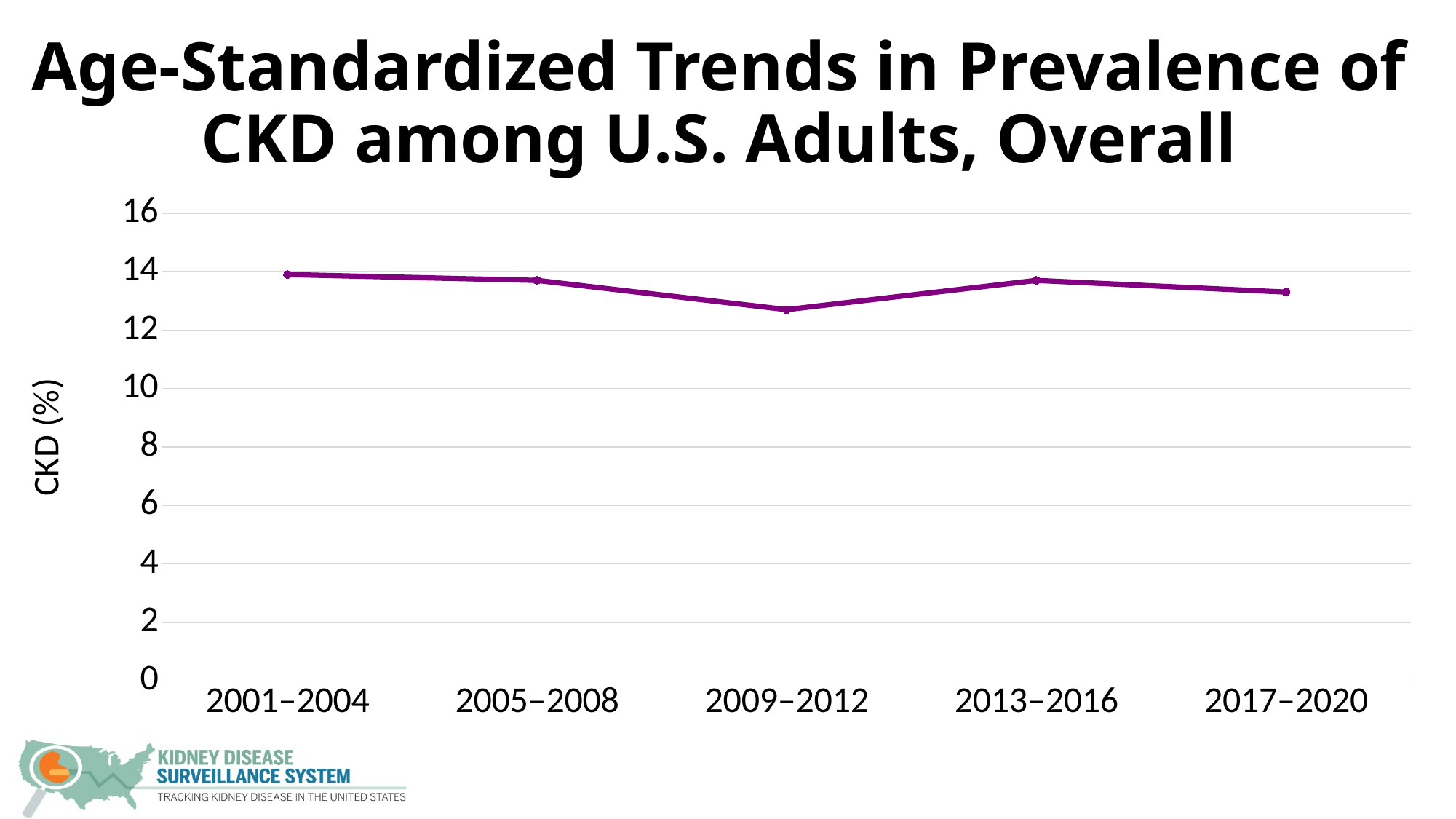
Is the CKD prevalence for 2009–2012 greater or less than 14? less Which is larger, the CKD prevalence for 2009–2012 or for 2017–2020? 2017–2020 Is the CKD prevalence for 2017–2020 greater or less than 12? greater How many time periods are plotted on the x axis? 5 Is the CKD prevalence for 2009–2012 greater or less than 12? greater Which time period has the lowest CKD prevalence? 2009–2012 What is the title of the chart? Age-Standardized Trends in Prevalence of CKD among U.S. Adults, Overall Which is larger, the CKD prevalence for 2001–2004 or for 2009–2012? 2001–2004 What kind of chart is shown on the slide? line chart What is the label on the y axis? CKD (%) Does the CKD prevalence rise or fall from 2001–2004 to 2009–2012? fall